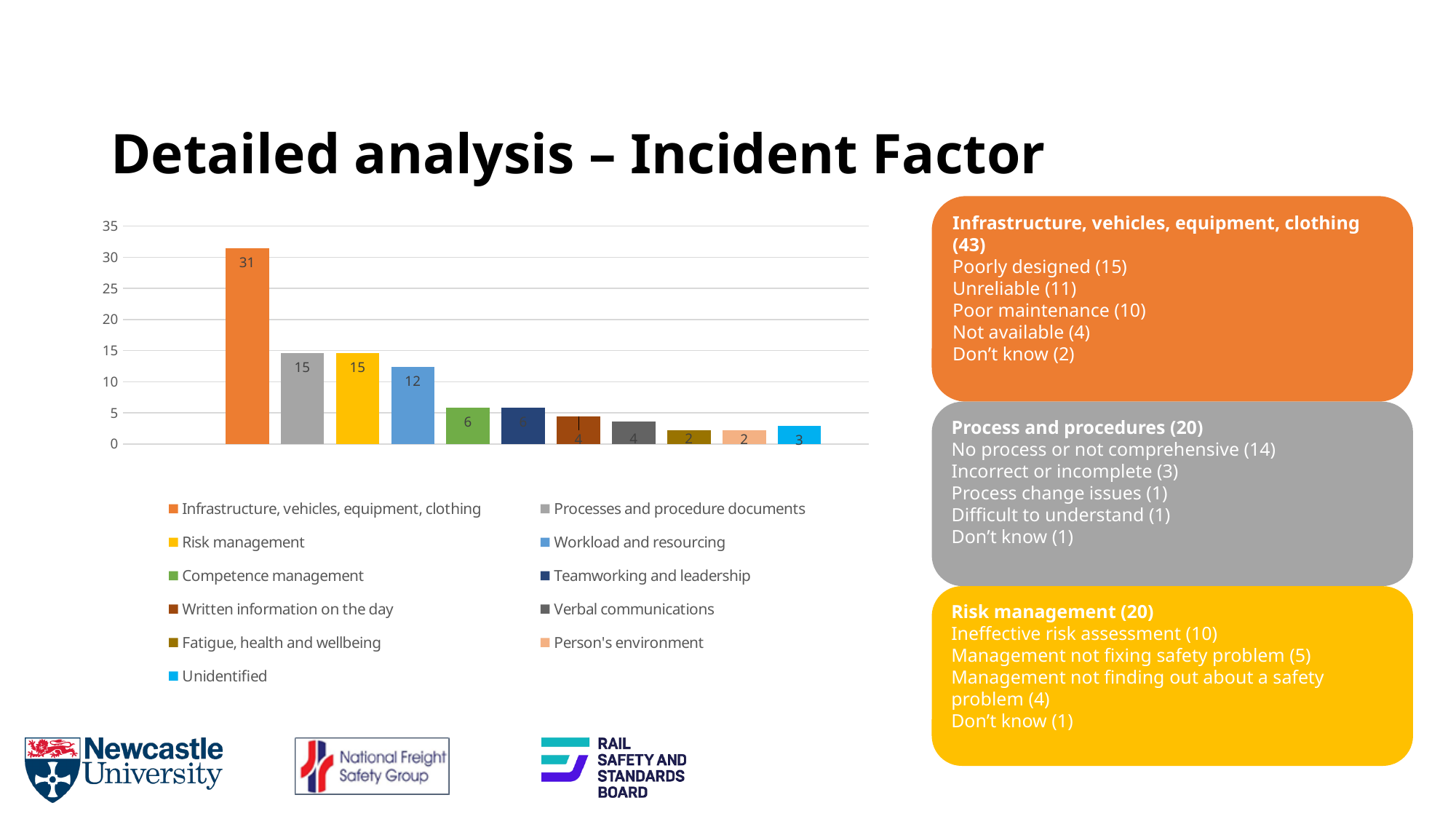
What is the value for Infrastructure, vehicles, equipment, clothing? 31 Which is larger, the value for Workload and resourcing or the value for Verbal communications? Workload and resourcing Which category has the highest value? Infrastructure, vehicles, equipment, clothing What is the value for Unidentified? 3 What is the difference between the values for Workload and resourcing and Competence management? 6 What colour is the bar for Risk management? Yellow What is the value for Workload and resourcing? 12 Is the value for Infrastructure, vehicles, equipment, clothing greater or less than 30? greater What is the difference between the values for Infrastructure, vehicles, equipment, clothing and Risk management? 16 What is the value for Competence management? 6 How many series does the legend list? 11 What kind of chart is shown on the slide? Bar chart